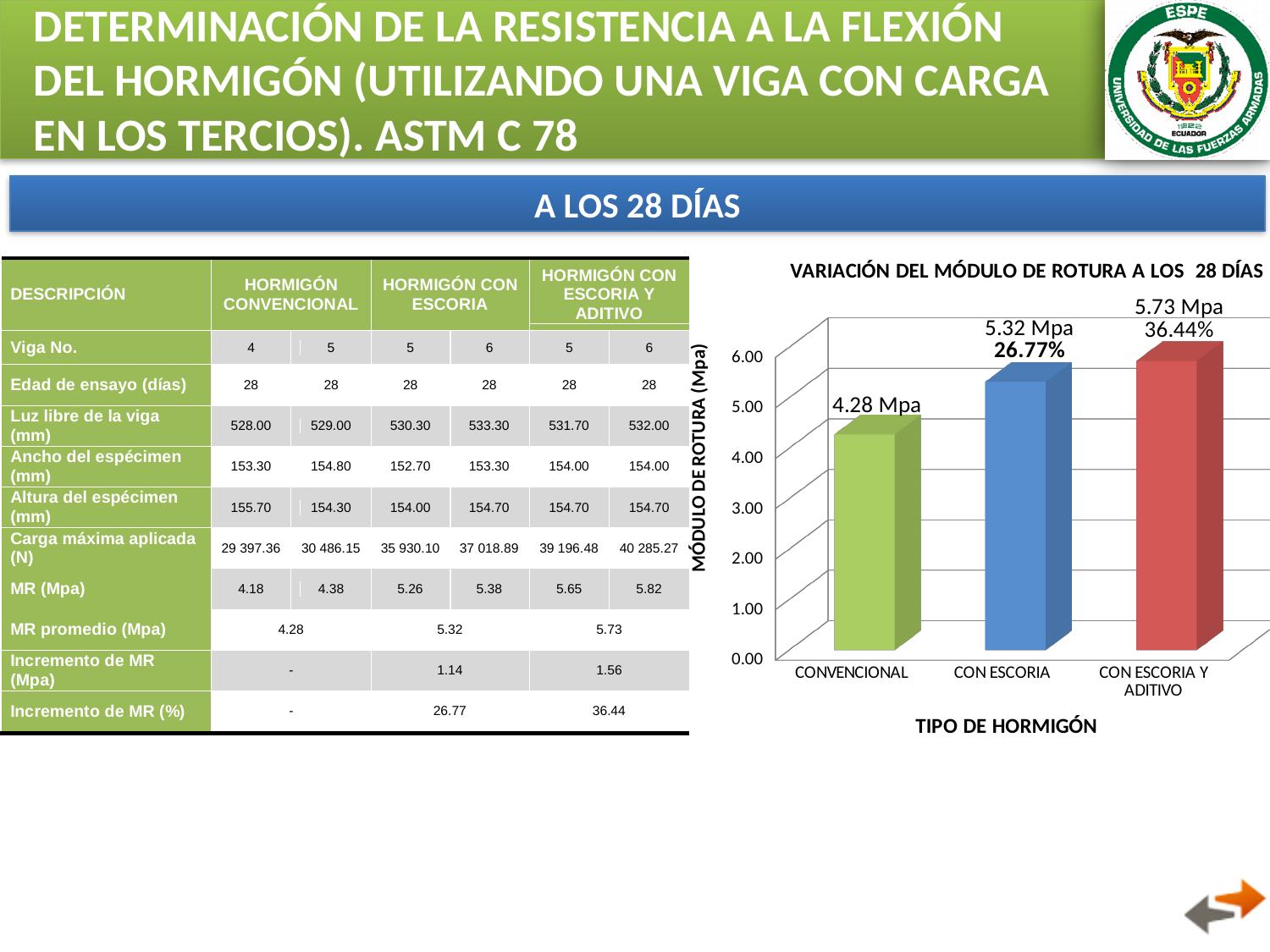
Is the value for CON ESCORIA greater or less than 5.00? greater Which is larger, the value for CON ESCORIA or the value for CONVENCIONAL? CON ESCORIA What is the value for CONVENCIONAL in the chart? 4.28 Mpa What is the difference between the values for CON ESCORIA Y ADITIVO and CONVENCIONAL? 1.45 Mpa What is the value for CON ESCORIA Y ADITIVO in the chart? 5.73 Mpa Which type of concrete has the lowest módulo de rotura in the chart? CONVENCIONAL What is the value for CON ESCORIA in the chart? 5.32 Mpa Which type of concrete has the highest módulo de rotura in the chart? CON ESCORIA Y ADITIVO What kind of chart is shown on the slide? bar chart What is the title of the chart? VARIACIÓN DEL MÓDULO DE ROTURA A LOS 28 DÍAS How many categories are shown on the x axis of the chart? 3 Do the values rise or fall from left to right along the x axis? rise